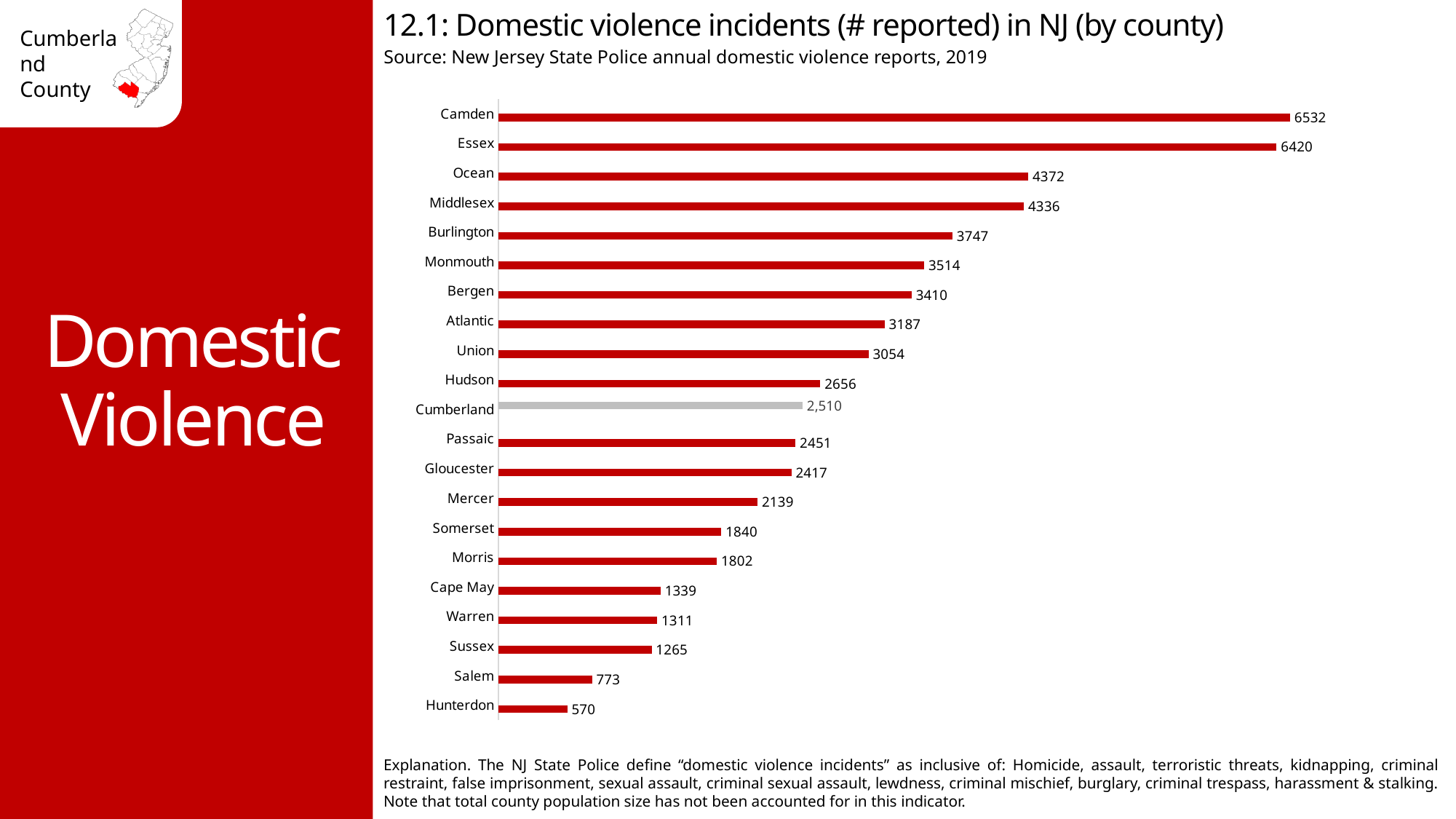
What is the value shown for Cumberland County? 2,510 How many domestic violence incidents were reported in Camden County? 6532 Which county has the highest number of reported domestic violence incidents? Camden What is the difference between the values for Camden and Essex? 112 What kind of chart is shown on the slide? Bar chart What is the difference between the values for Salem and Hunterdon? 203 Which county has more reported incidents, Ocean or Middlesex? Ocean Which county's bar is shown in grey instead of red? Cumberland How many counties are shown in the chart? 21 How many incidents were reported in Cape May? 1339 Which county has the lowest number of reported domestic violence incidents? Hunterdon Which county has more reported incidents, Hudson or Cumberland? Hudson